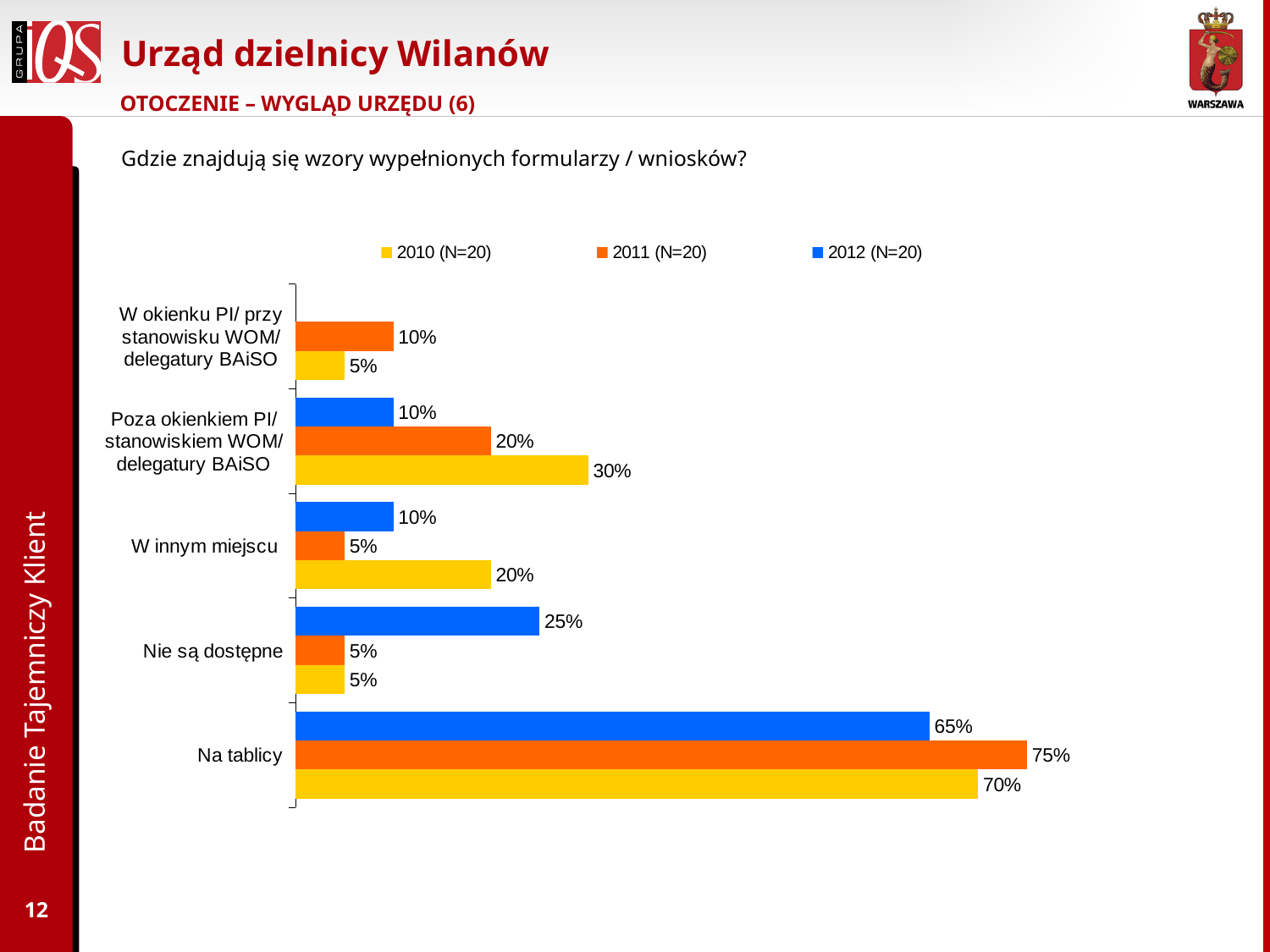
How many categories are shown on the chart? 5 What is the value for 'Na tablicy' in the 2011 (N=20) series? 75% Which category has the highest value in the 2012 (N=20) series? Na tablicy What is the value for 'W innym miejscu' in the 2011 (N=20) series? 5% Which colour represents the 2012 (N=20) series in the legend? blue What is the value for 'Nie są dostępne' in the 2012 (N=20) series? 25% What is the difference between the 2011 (N=20) and 2012 (N=20) values for 'Na tablicy'? 10% What kind of chart is shown on the slide? bar chart What is the value for 'Poza okienkiem PI/ stanowiskiem WOM/ delegatury BAiSO' in the 2010 (N=20) series? 30% For 'W innym miejscu', which series has the larger value: 2010 (N=20) or 2012 (N=20)? 2010 (N=20) How many series does the legend list? 3